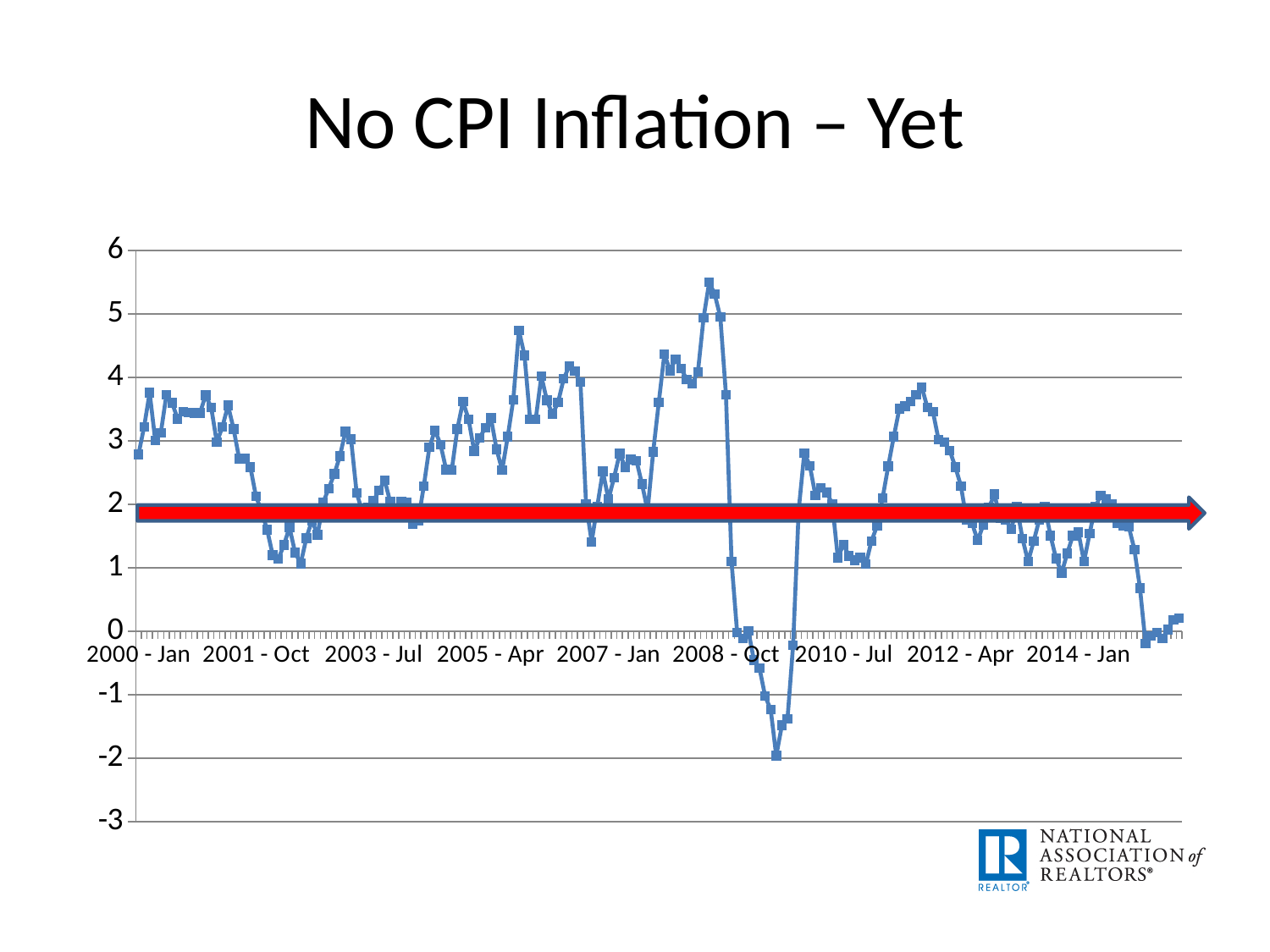
Is the highest point on the line greater or less than 5? greater Is the value at 2000 - Jan greater or less than 2? greater Is the lowest point on the line greater or less than -1? less What is the title of the slide's chart? No CPI Inflation – Yet How many date labels are shown on the x axis? 9 What is the highest value shown on the y axis? 6 Does the line rise or fall from 2012 - Apr to 2014 - Jan? fall Is the value at 2000 - Jan larger or smaller than the value at 2014 - Jan? larger What kind of chart is shown on the slide? line chart